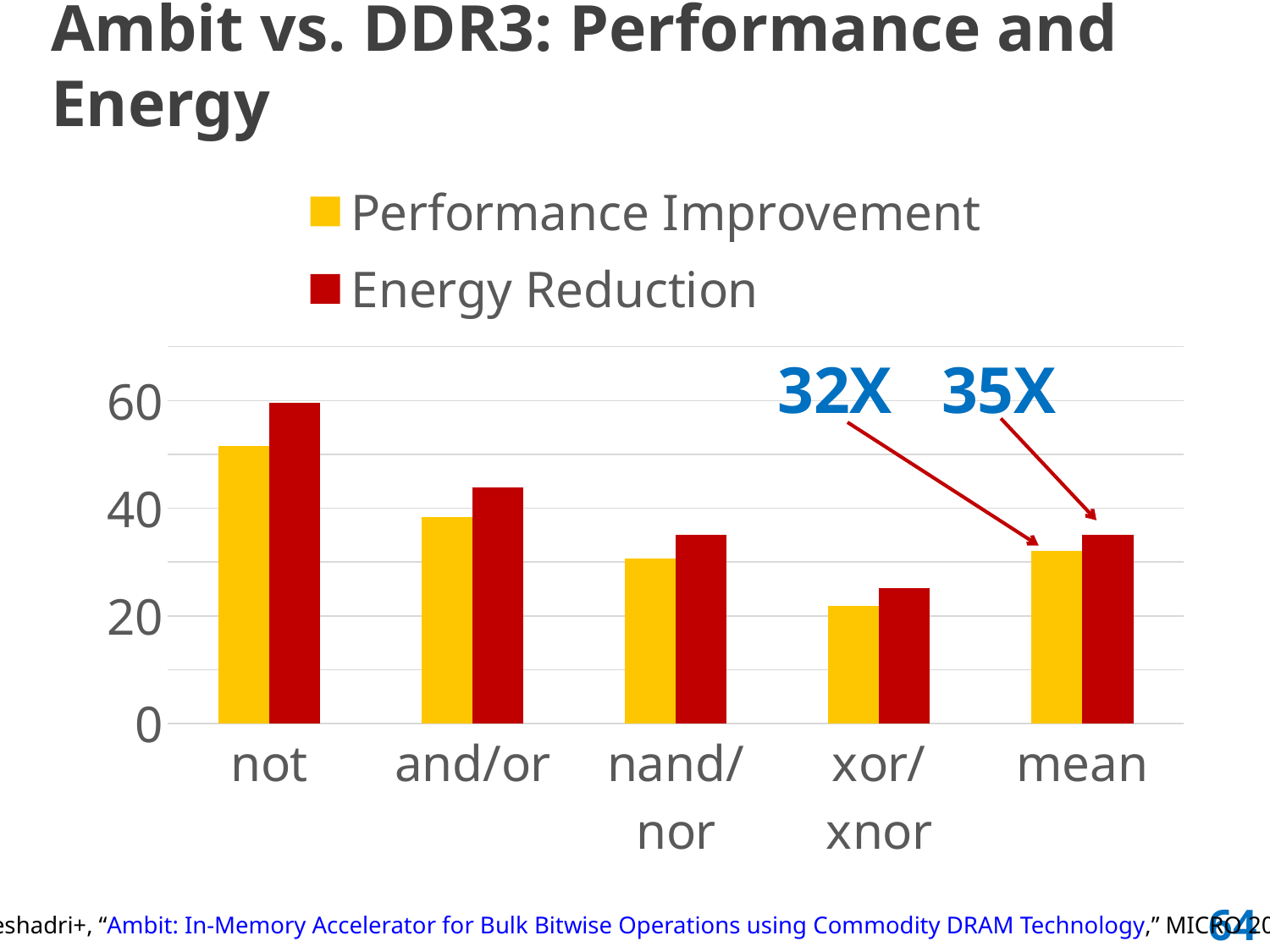
How many categories are shown on the x axis? 5 Which category has the highest Performance Improvement? not How many series does the legend list? 2 Which colour represents Energy Reduction in the legend? red What is the Energy Reduction value annotated for the mean category? 35X What kind of chart is shown on the slide? bar chart Which category has the lowest Energy Reduction? xor/xnor Is the Performance Improvement value for xor/xnor greater or less than 40? less Do the Performance Improvement values rise or fall from not to xor/xnor? fall What is the Performance Improvement value annotated for the mean category? 32X Is the Energy Reduction value for not greater or less than 40? greater Which is larger for and/or: Performance Improvement or Energy Reduction? Energy Reduction